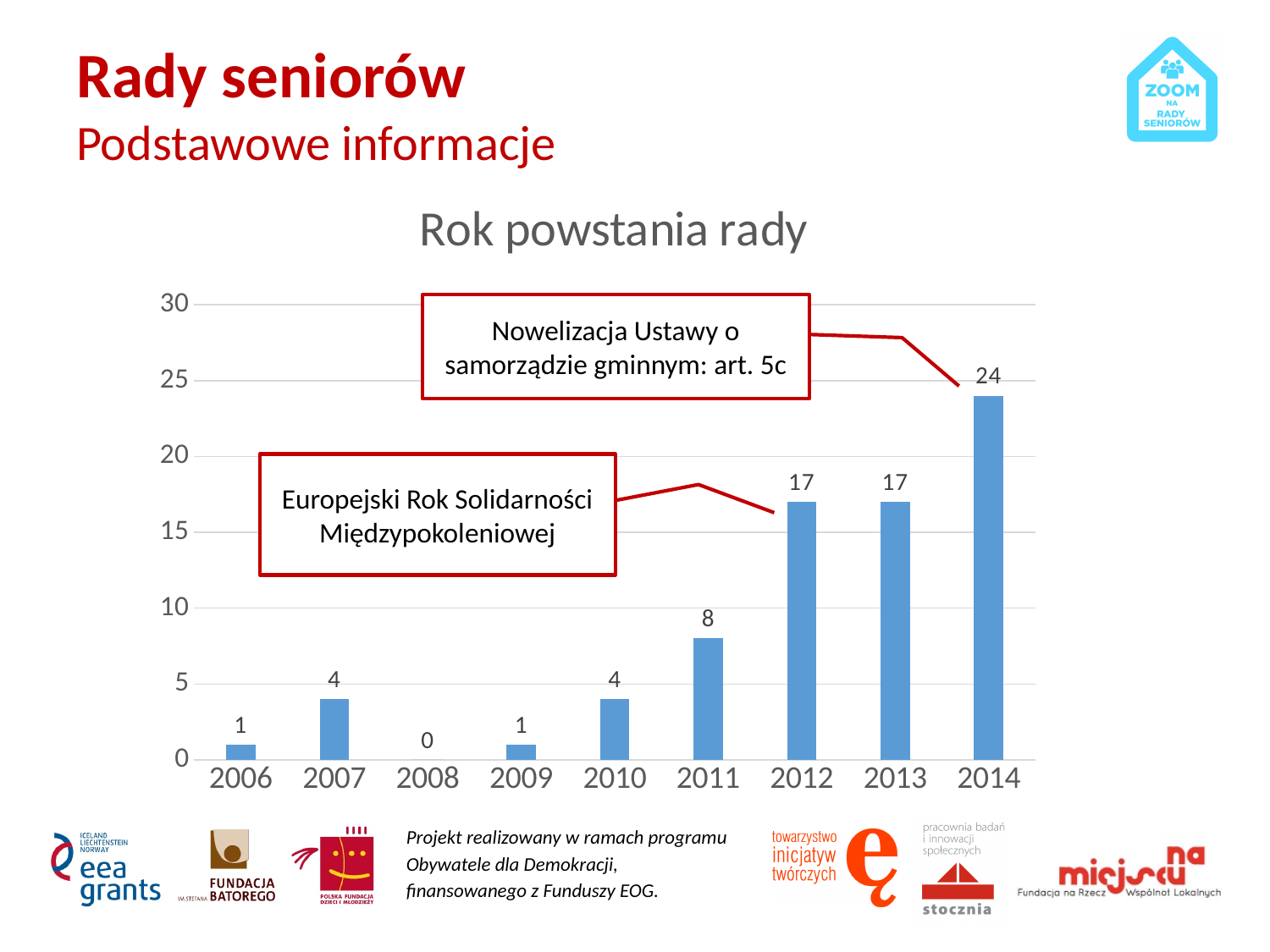
What is the value for 2008 in the 'Rok powstania rady' chart? 0 Which is larger in the 'Rok powstania rady' chart: the value for 2011 or the value for 2010? 2011 What is the title of the chart on the slide? Rok powstania rady What kind of chart is 'Rok powstania rady'? bar chart Do the values in the 'Rok powstania rady' chart generally rise or fall from 2009 to 2014? rise Which year has the lowest value in the 'Rok powstania rady' chart? 2008 What is the difference between the values for 2014 and 2013 in the 'Rok powstania rady' chart? 7 What is the value for 2011 in the 'Rok powstania rady' chart? 8 What is the value for 2014 in the 'Rok powstania rady' chart? 24 Which year has the highest value in the 'Rok powstania rady' chart? 2014 Is the value for 2012 in the 'Rok powstania rady' chart greater or less than 15? greater How many years are shown on the x axis of the 'Rok powstania rady' chart? 9